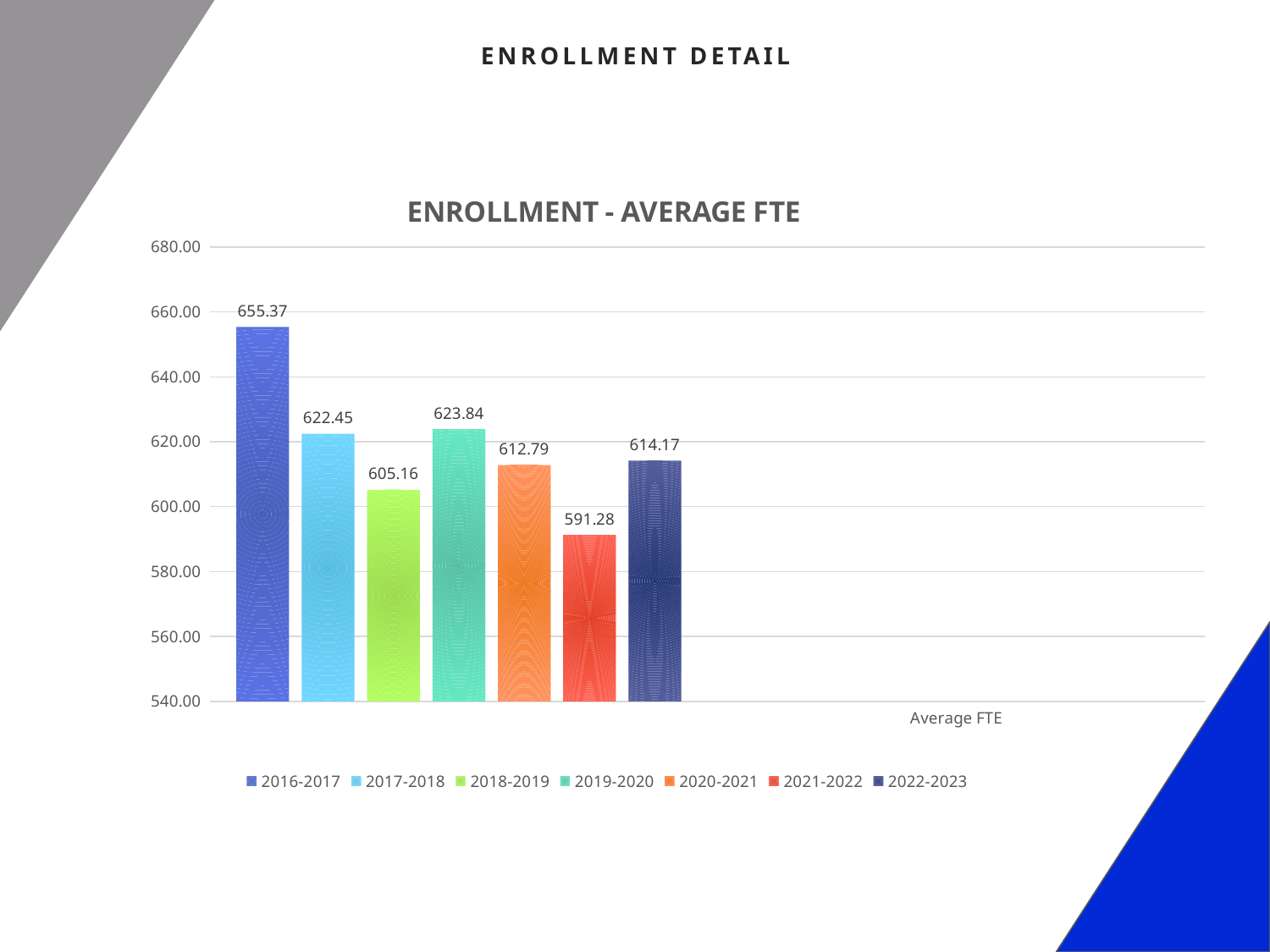
What is the title of the chart? ENROLLMENT - AVERAGE FTE How many series does the legend list? 7 What is the Average FTE for 2016-2017? 655.37 Which has a larger Average FTE, 2017-2018 or 2020-2021? 2017-2018 What is the Average FTE for 2021-2022? 591.28 Which school year has the lowest Average FTE? 2021-2022 Which school year has the highest Average FTE? 2016-2017 What kind of chart is shown on the slide? Bar chart What is the Average FTE for 2022-2023? 614.17 What is the difference in Average FTE between 2019-2020 and 2018-2019? 18.68 Is the Average FTE for 2018-2019 greater or less than 600.00? greater What is the difference in Average FTE between 2016-2017 and 2021-2022? 64.09